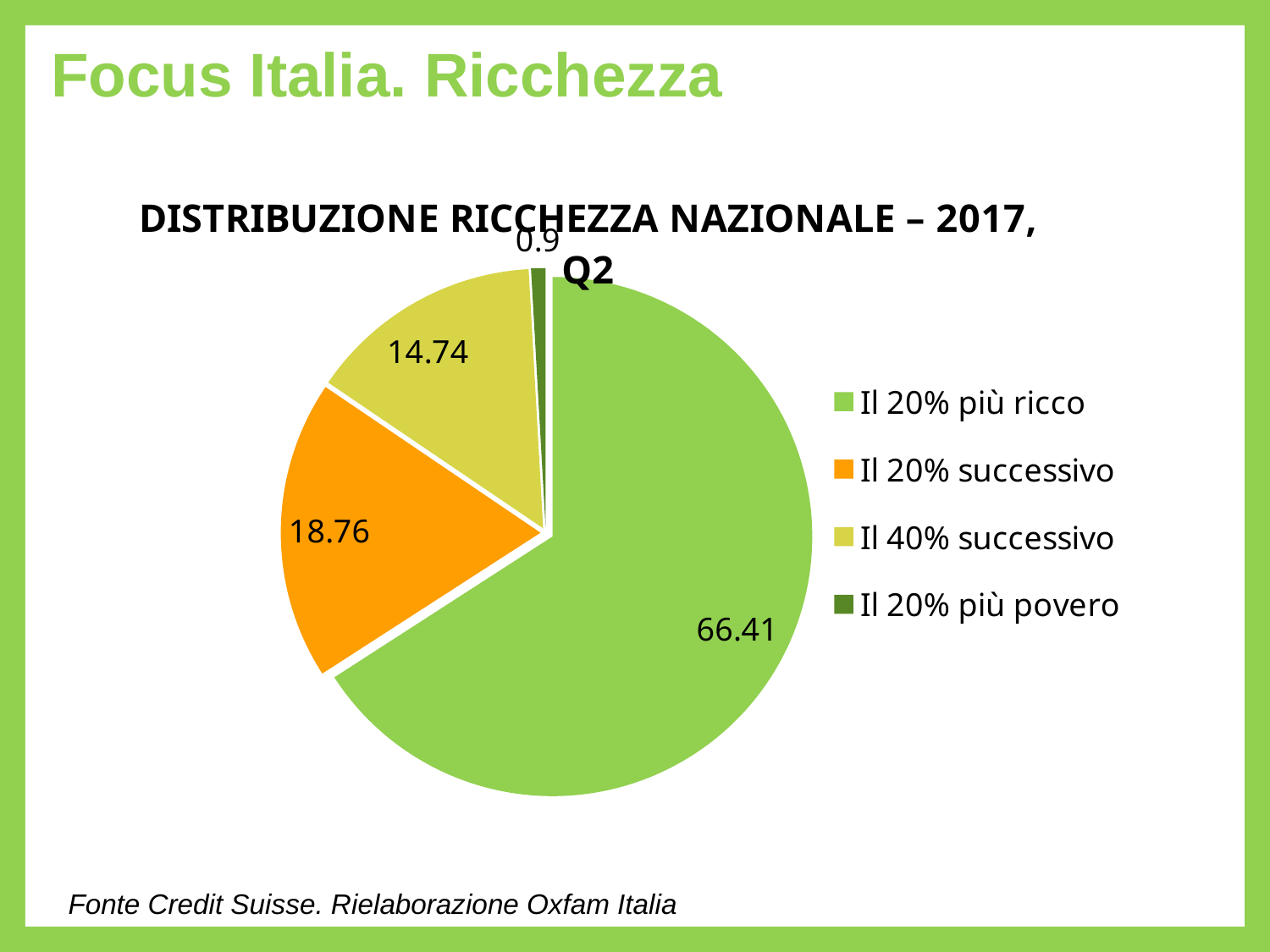
Which is larger, the value for "Il 20% successivo" or the value for "Il 40% successivo"? Il 20% successivo What is the difference between the values for "Il 20% più ricco" and "Il 20% successivo"? 47.65 What is the value for "Il 20% più povero" in the pie chart? 0.9 What is the value for "Il 20% successivo" in the pie chart? 18.76 How many categories does the pie chart have? 4 What is the value for "Il 20% più ricco" in the pie chart? 66.41 What is the title of the pie chart? DISTRIBUZIONE RICCHEZZA NAZIONALE – 2017, Q2 What is the value for "Il 40% successivo" in the pie chart? 14.74 Which category has the largest slice of the pie chart? Il 20% più ricco Which category has the smallest slice of the pie chart? Il 20% più povero What kind of chart is shown on the slide? pie chart What is the difference between the values for "Il 20% successivo" and "Il 40% successivo"? 4.02